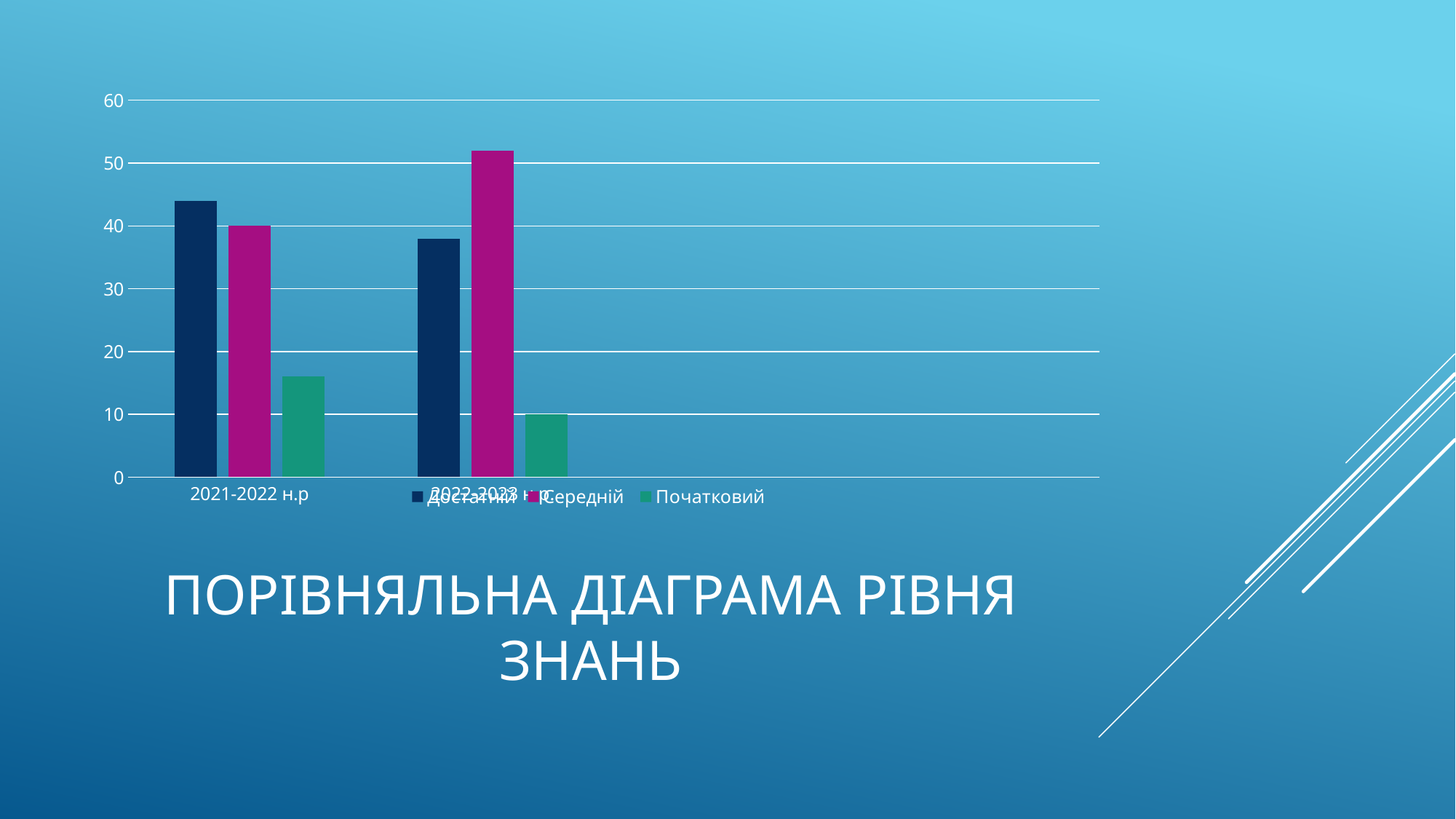
How many categories (school years) are shown on the x axis? 2 Which is larger: Достатній in 2021-2022 н.р or Достатній in 2022-2023 н.р? 2021-2022 н.р Is the value for Середній in 2022-2023 н.р greater or less than 50? greater What is the value of Середній for 2021-2022 н.р? 40 Does the Середній series rise or fall from 2021-2022 н.р to 2022-2023 н.р? rises Is the value for Достатній in 2021-2022 н.р greater or less than 40? greater What kind of chart is shown on the slide? bar chart Is the value for Початковий in 2021-2022 н.р greater or less than 20? less Which bar is the highest in the chart? Середній in 2022-2023 н.р How many series does the legend list? 3 What is the value of Початковий for 2022-2023 н.р? 10